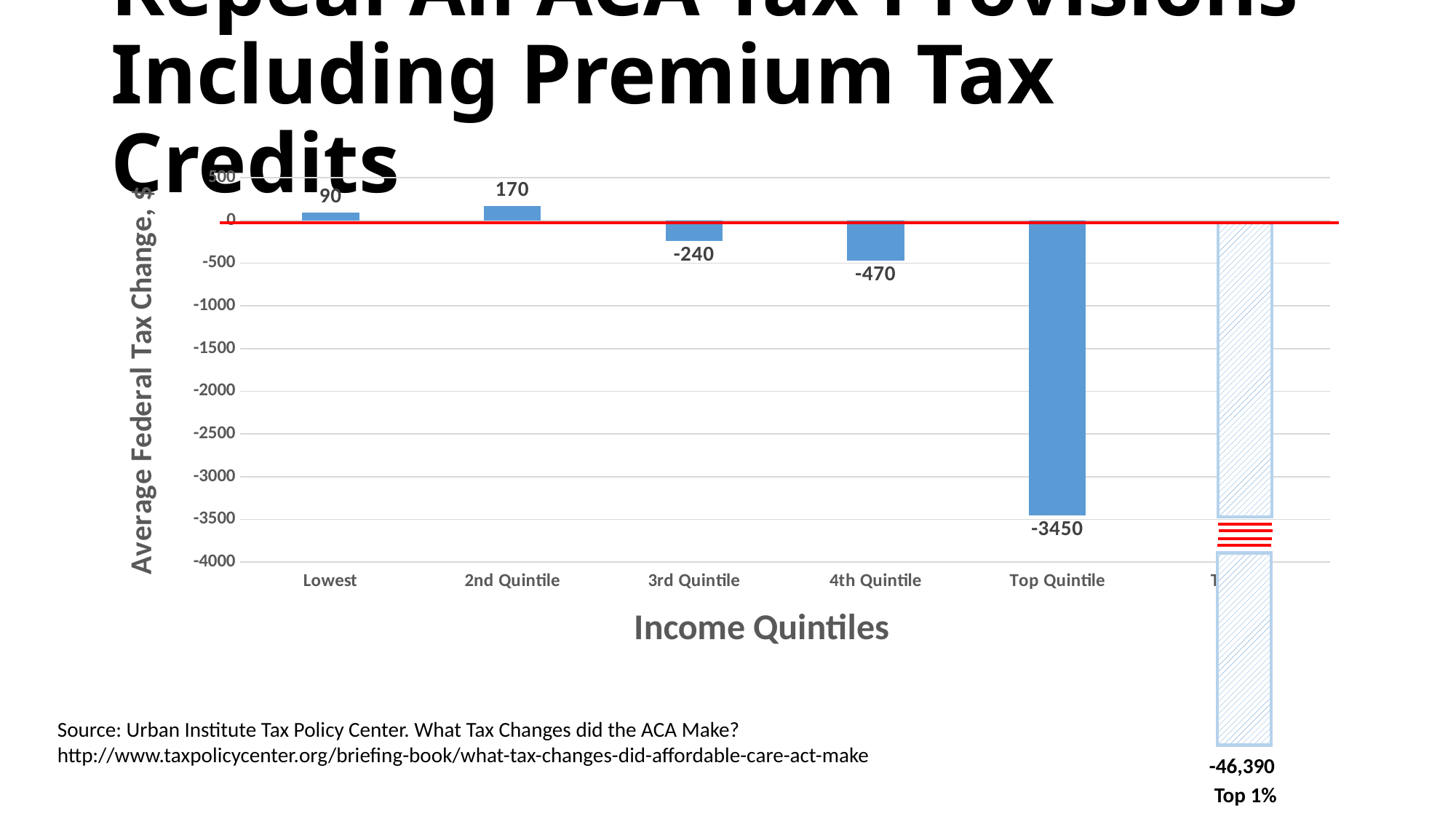
Which income group has the lowest (most negative) average federal tax change? Top 1% What is the difference between the values for the 2nd Quintile and the Lowest quintile? 80 What is the average federal tax change for the 2nd Quintile? 170 What is the average federal tax change for the 4th Quintile? -470 What is the label of the x axis? Income Quintiles What is the average federal tax change for the Top Quintile? -3450 Which has a larger tax change value, the 3rd Quintile or the 4th Quintile? 3rd Quintile What is the average federal tax change for the Lowest quintile? 90 What value is labeled for the Top 1% bar? -46,390 What is the average federal tax change for the 3rd Quintile? -240 What type of chart is shown on the slide? Bar chart Which income group has the highest (most positive) average federal tax change? 2nd Quintile